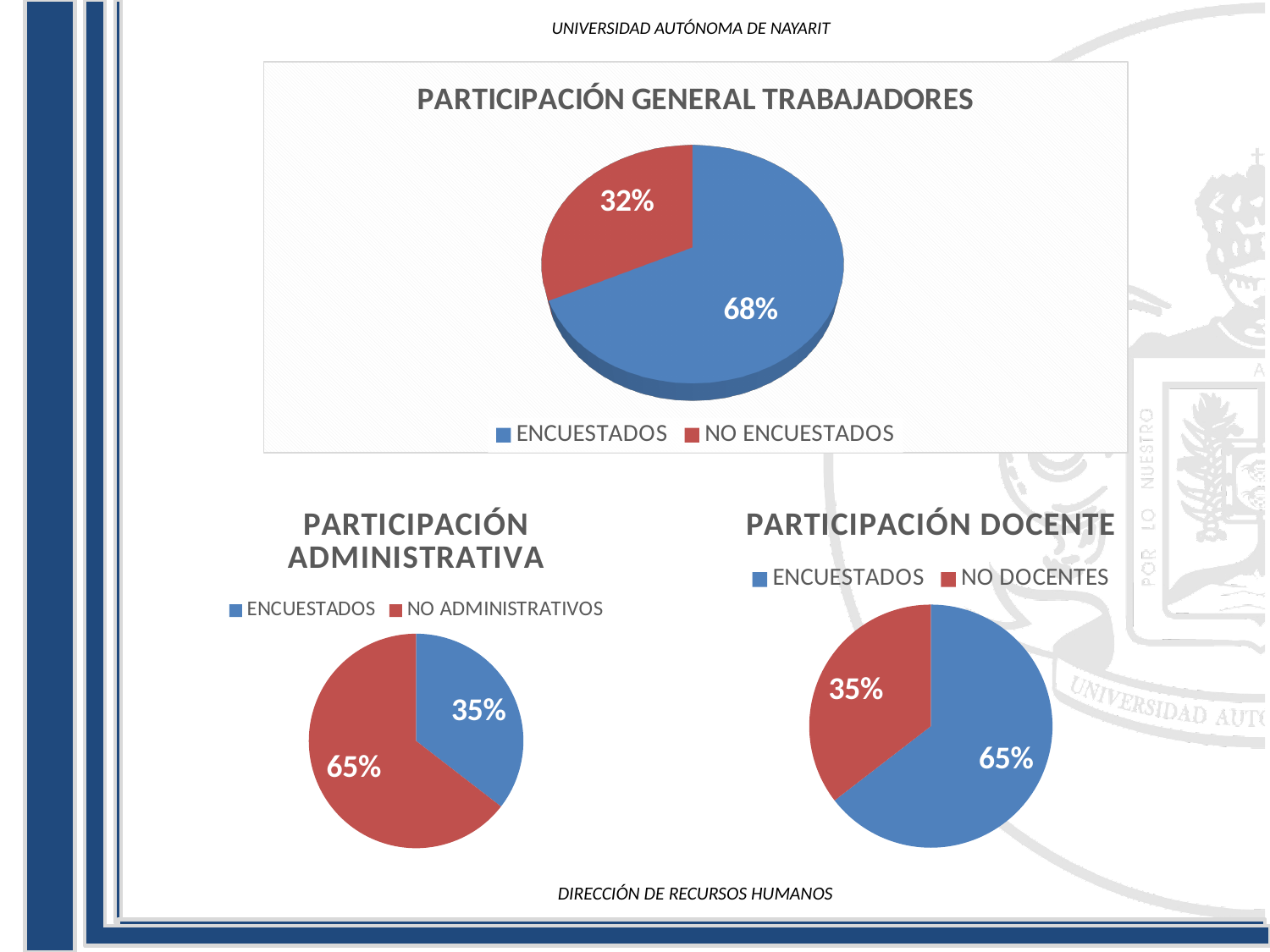
In the 'PARTICIPACIÓN GENERAL TRABAJADORES' chart, what share of the pie is ENCUESTADOS? 68% In the 'PARTICIPACIÓN GENERAL TRABAJADORES' chart, which slice is the largest? ENCUESTADOS In the 'PARTICIPACIÓN DOCENTE' chart, what share of the pie is ENCUESTADOS? 65% In the 'PARTICIPACIÓN GENERAL TRABAJADORES' chart, what is the difference between the ENCUESTADOS and NO ENCUESTADOS shares? 36% In the 'PARTICIPACIÓN DOCENTE' chart, which is larger, ENCUESTADOS or NO DOCENTES? ENCUESTADOS In the 'PARTICIPACIÓN ADMINISTRATIVA' chart, what share of the pie is NO ADMINISTRATIVOS? 65% What kind of chart is 'PARTICIPACIÓN GENERAL TRABAJADORES'? Pie chart How many entries does the legend of the 'PARTICIPACIÓN DOCENTE' chart list? 2 In the 'PARTICIPACIÓN ADMINISTRATIVA' chart, which slice is the smallest? ENCUESTADOS